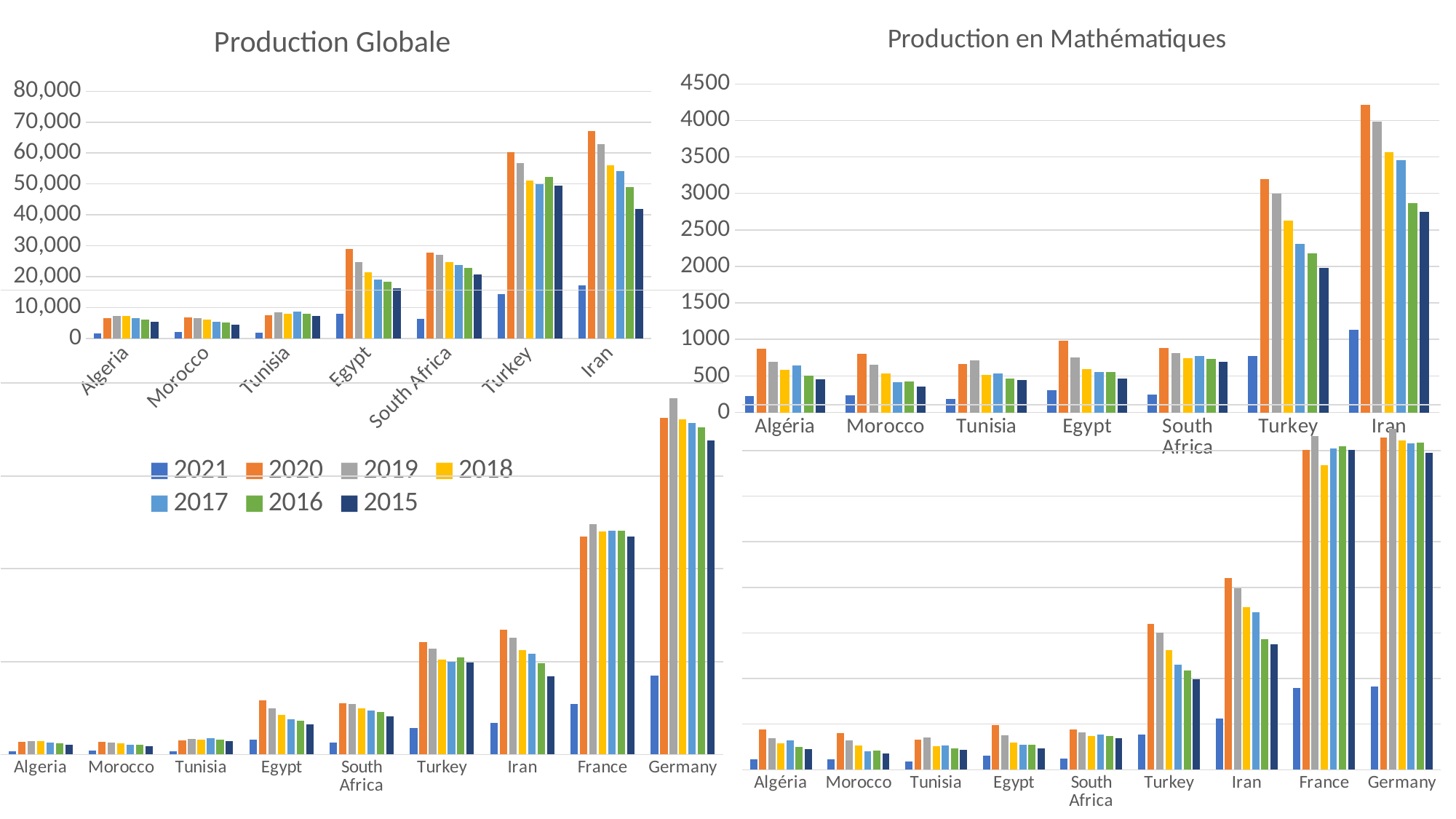
How many series does the legend on the slide list? 7 In the Production en Mathématiques chart, which country has the tallest bar? Iran In the Production Globale chart, is the value for Iran in 2020 greater or less than 60,000? greater In the Production en Mathématiques chart, is the value for Turkey in 2020 greater or less than 3000? greater In the Production Globale chart, which country has the tallest bar? Iran In the Production en Mathématiques chart, is the value for Iran in 2020 greater or less than 4000? greater In the Production Globale chart, which is larger, the 2020 value for Turkey or the 2020 value for Iran? Iran In the Production en Mathématiques chart, which is larger, the 2021 value for Turkey or the 2021 value for Iran? Iran In the bottom-left chart, which country has the tallest bar? Germany How many countries are shown on the x axis of the Production Globale chart? 7 What kind of chart is the Production Globale chart? bar chart